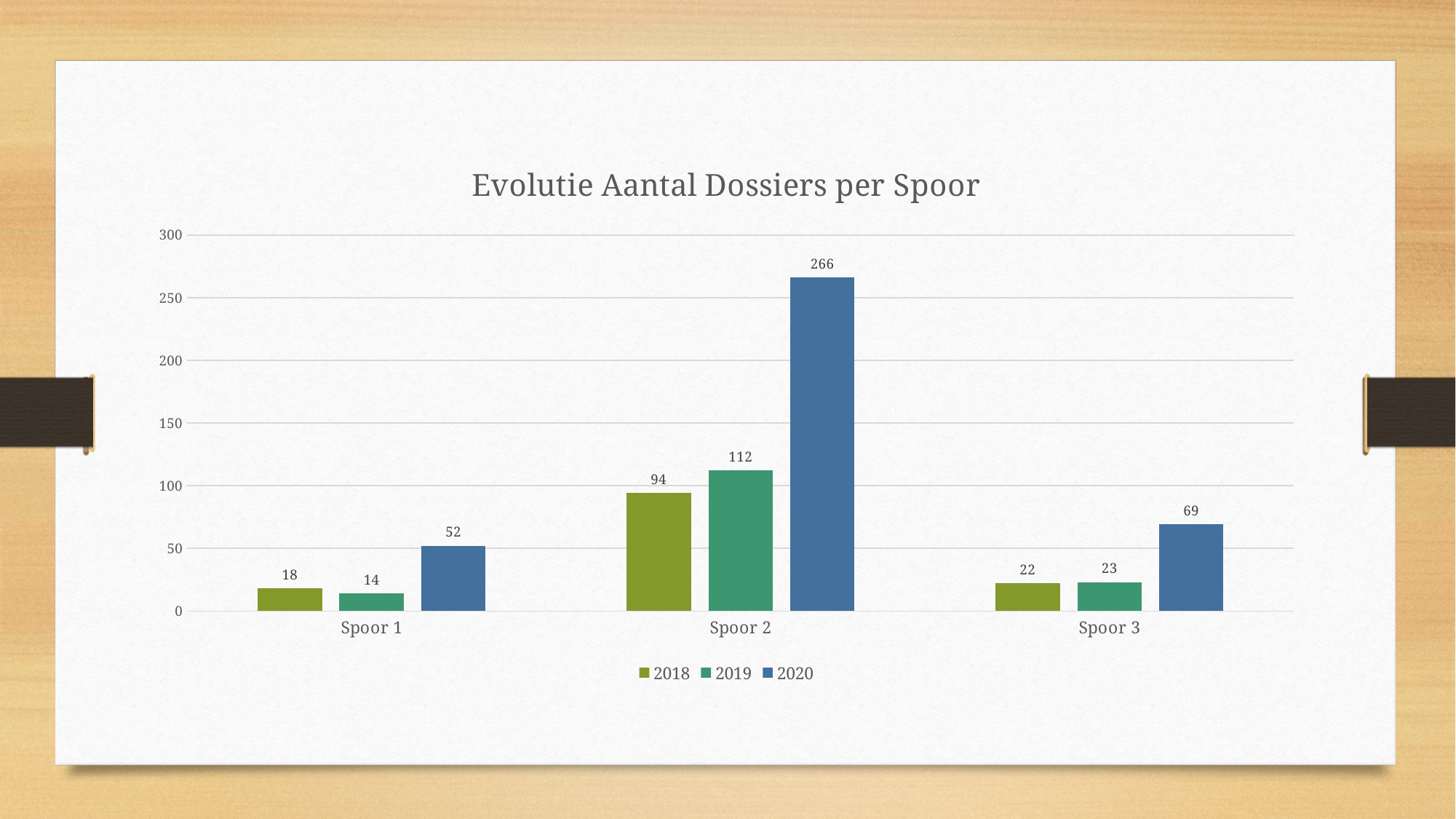
Which category has the lowest value for the 2019 series? Spoor 1 Which category has the highest value for the 2020 series? Spoor 2 How many series does the legend list? 3 What is the value for 2019 in Spoor 3? 23 What is the difference between the 2020 and 2019 values in Spoor 2? 154 How many categories are shown on the x axis? 3 What is the title of the chart? Evolutie Aantal Dossiers per Spoor What is the difference between the 2020 values for Spoor 3 and Spoor 1? 17 What is the value for 2018 in Spoor 1? 18 What kind of chart is shown on the slide? Bar chart Which is larger: the 2018 value for Spoor 3 or the 2019 value for Spoor 1? 2018 value for Spoor 3 What is the value for 2020 in Spoor 2? 266